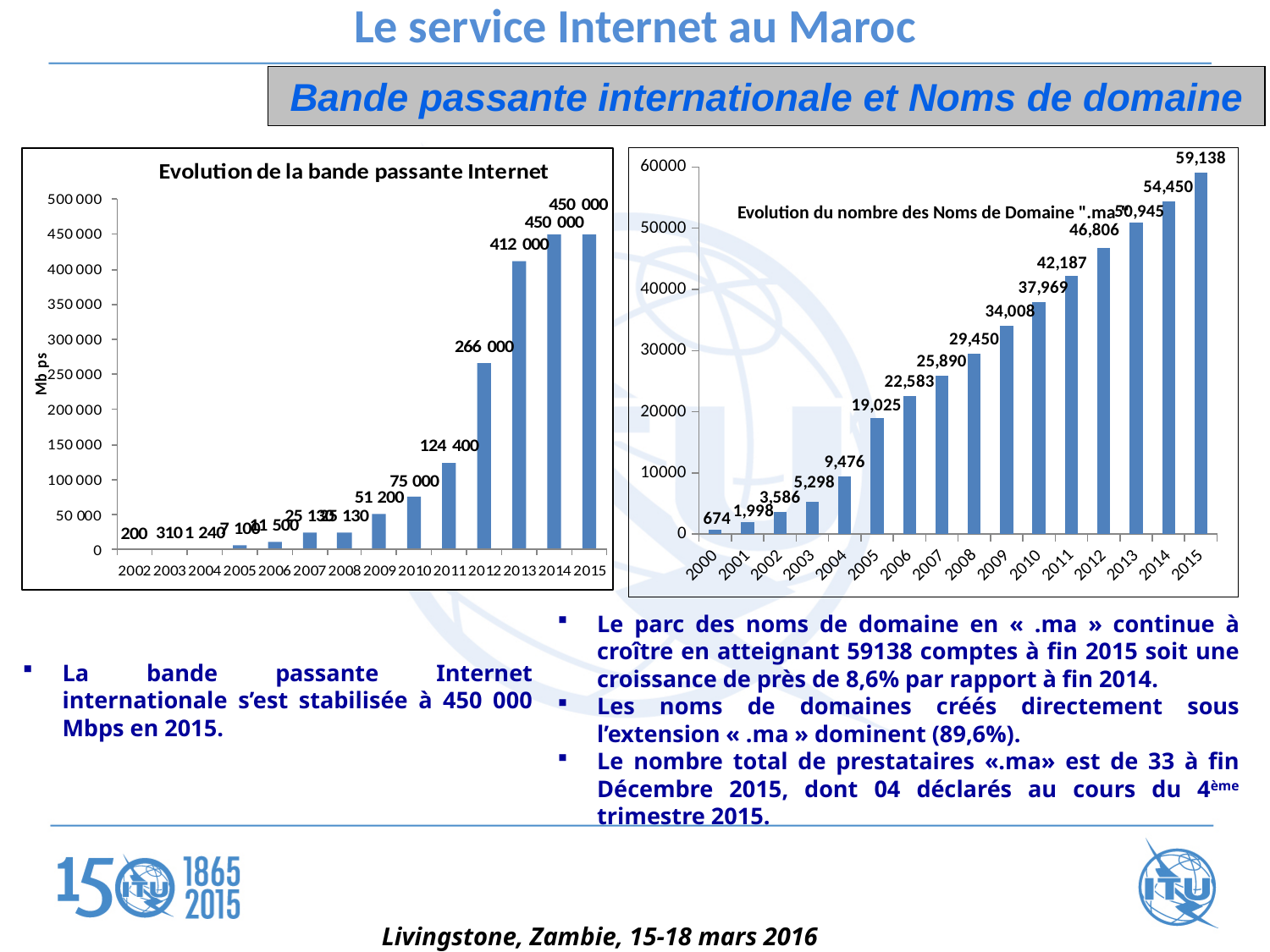
In the chart 'Evolution du nombre des Noms de Domaine ".ma"', what is the difference between the values for 2015 and 2014? 4,688 In the chart 'Evolution du nombre des Noms de Domaine ".ma"', do the values rise or fall from 2000 to 2015? Rise In the chart 'Evolution de la bande passante Internet', which year has the lowest value? 2002 In the chart 'Evolution de la bande passante Internet', what is the value for 2010? 75 000 In the chart 'Evolution du nombre des Noms de Domaine ".ma"', what is the value for 2015? 59,138 What kind of chart is the chart on the right of the slide? Bar chart In the chart 'Evolution de la bande passante Internet', what is the difference between the values for 2013 and 2012? 146 000 In the chart 'Evolution de la bande passante Internet', how many years are shown on the x axis? 14 In the chart 'Evolution de la bande passante Internet', which year has the larger value, 2009 or 2011? 2011 In the chart 'Evolution du nombre des Noms de Domaine ".ma"', which year has the highest value? 2015 In the chart 'Evolution du nombre des Noms de Domaine ".ma"', what is the value for 2005? 19,025 In the chart 'Evolution de la bande passante Internet', what is the value for 2012? 266 000